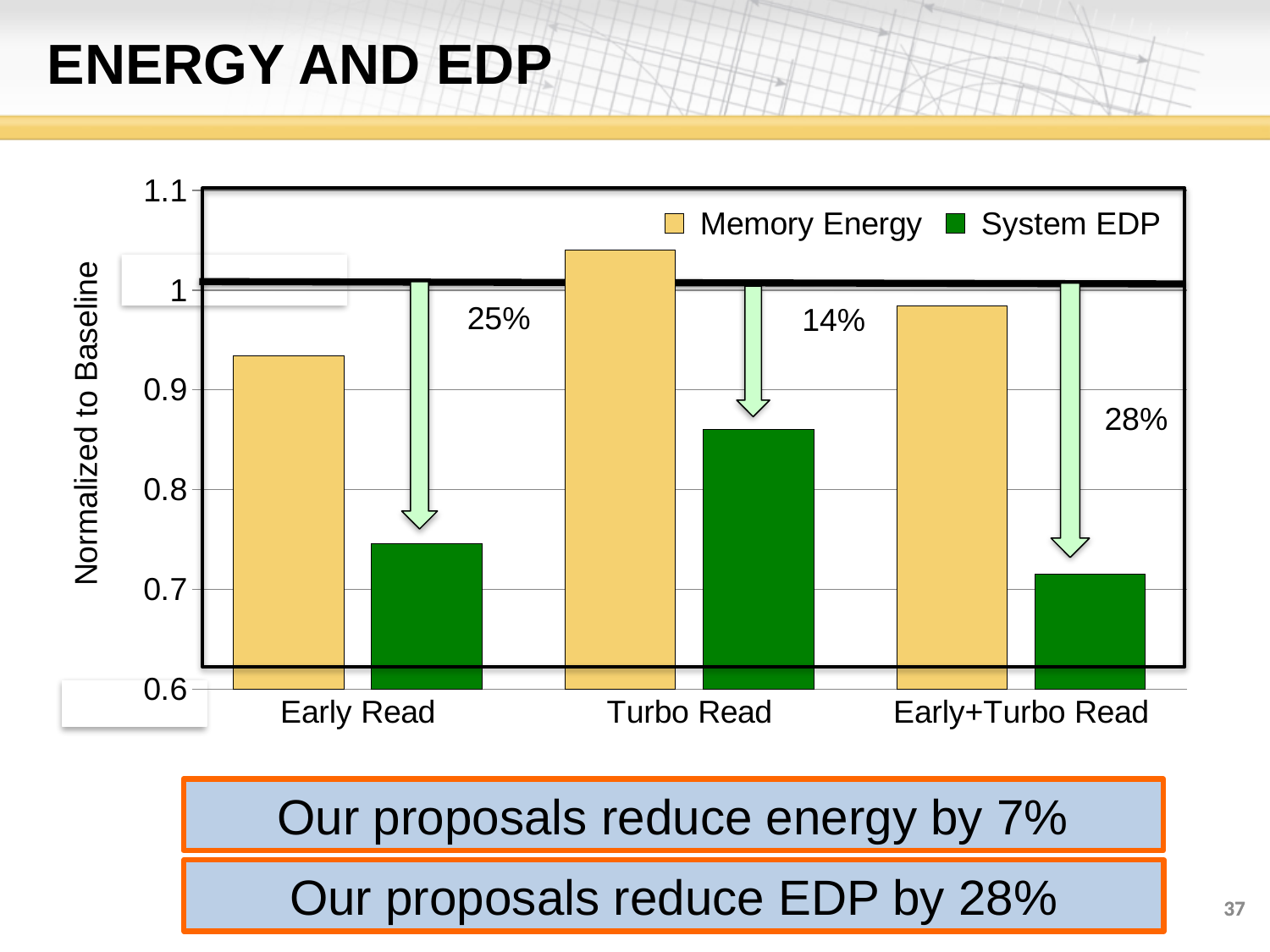
How many categories are shown on the x axis? 3 For Early+Turbo Read, which is larger: Memory Energy or System EDP? Memory Energy Which category has the highest System EDP value? Turbo Read What percentage reduction is annotated above the System EDP bar for Turbo Read? 14% Is the Memory Energy value for Early Read greater or less than 0.9? greater What is the label on the y axis of the chart? Normalized to Baseline Which category has the highest Memory Energy value? Turbo Read How many series does the legend list? 2 Is the Memory Energy value for Turbo Read greater or less than 1? greater What kind of chart is shown on the slide? bar chart Is the System EDP value for Early Read greater or less than 0.8? less Which category has the lowest System EDP value? Early+Turbo Read